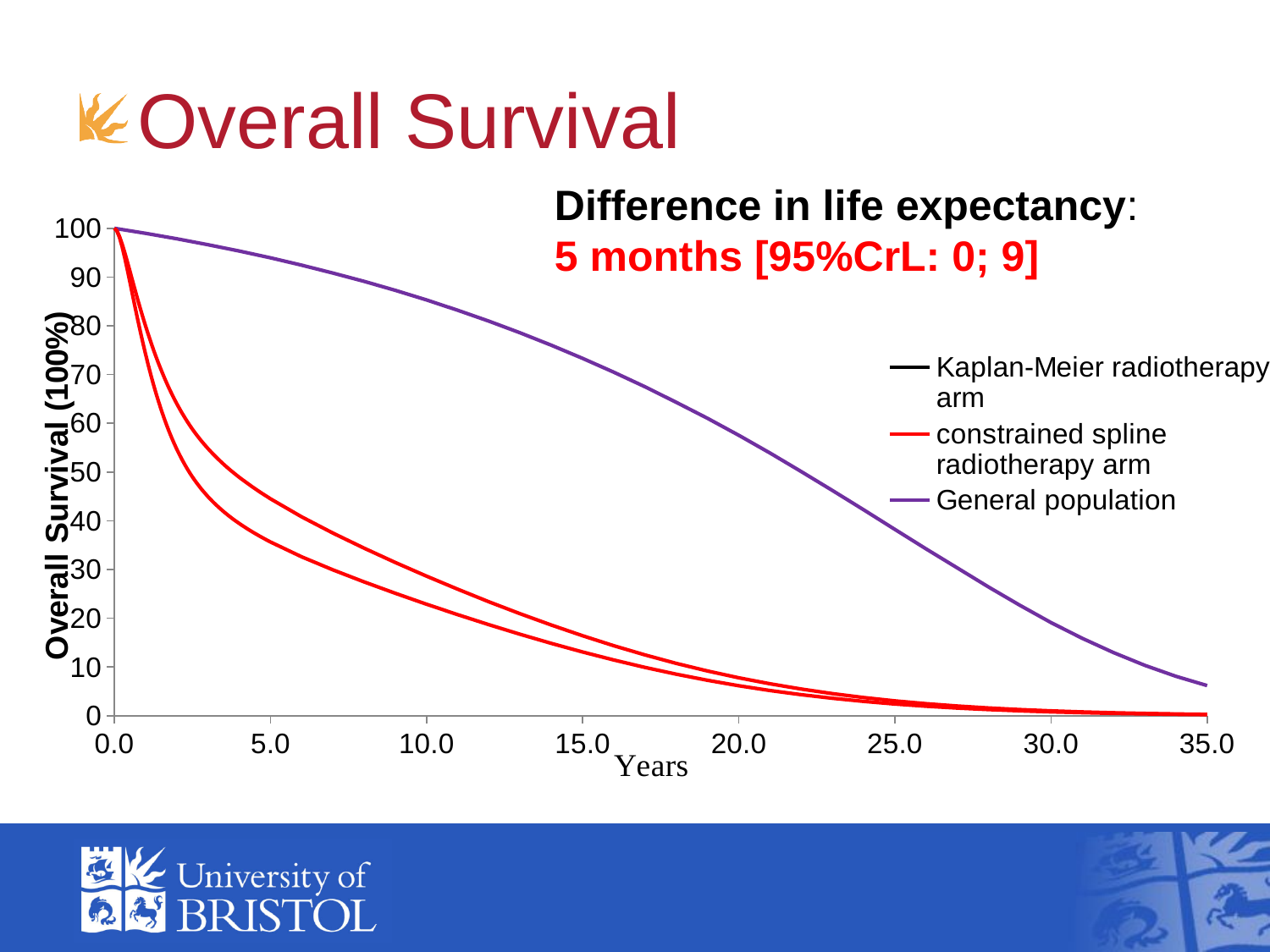
Is the General population survival at 30.0 years greater or less than 20? less What kind of chart is shown on the slide? line chart What colour is the General population line in the legend? purple Is the General population survival at 10.0 years greater or less than 80? greater How many series does the legend list? 3 Is the constrained spline radiotherapy arm survival at 20.0 years greater or less than 10? less Do the survival curves rise or fall as years increase along the x axis? fall What is the overall survival value for all series at 0.0 years? 100 At 20.0 years, which series has the highest overall survival? General population At 10.0 years, which is higher: the General population curve or the constrained spline radiotherapy arm curve? General population